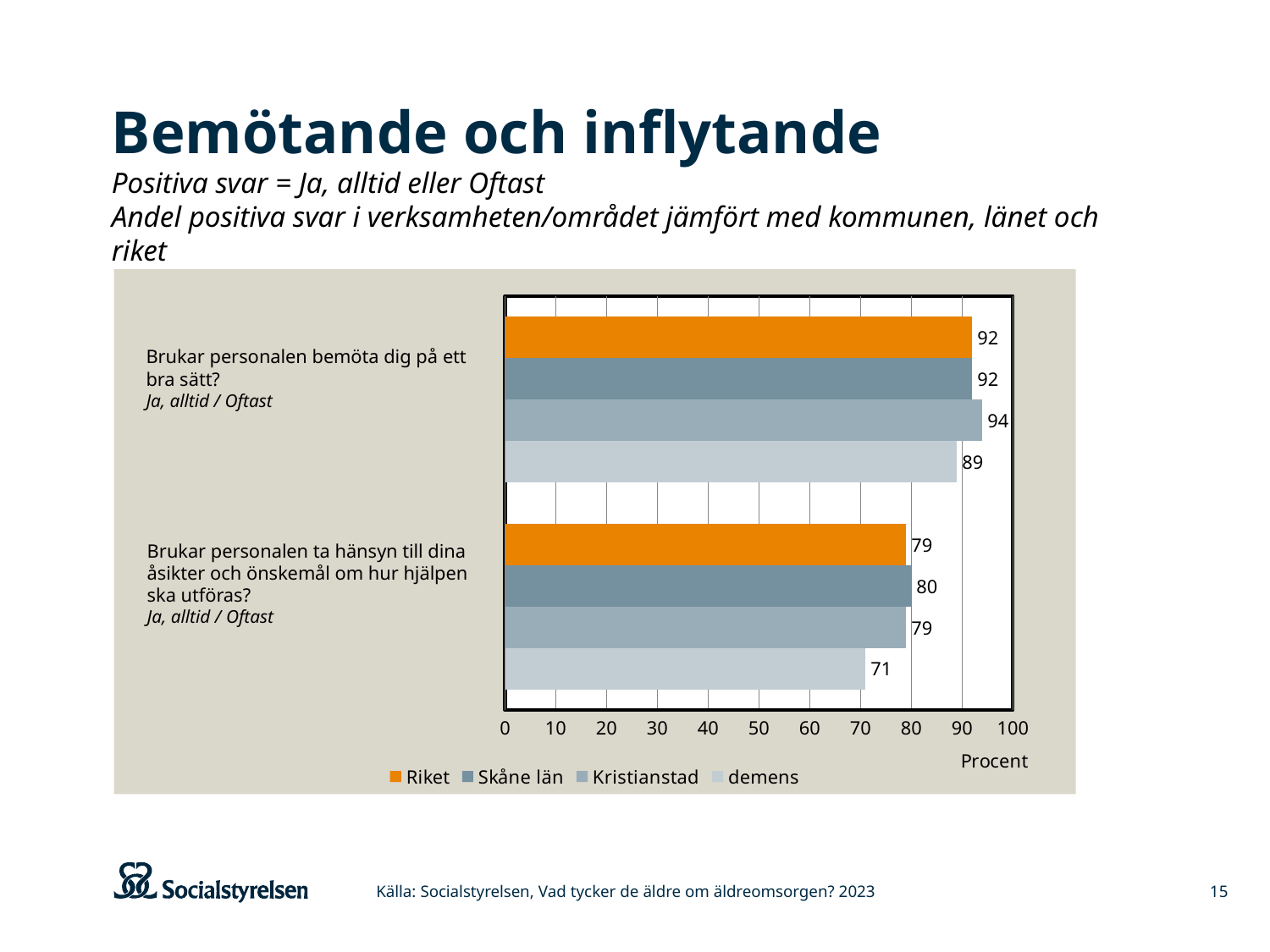
What is the difference between the Kristianstad and demens values for the question "Brukar personalen bemöta dig på ett bra sätt?" 5 What is the value for demens for the question "Brukar personalen ta hänsyn till dina åsikter och önskemål om hur hjälpen ska utföras?" 71 Which series has the lowest value for the question "Brukar personalen ta hänsyn till dina åsikter och önskemål om hur hjälpen ska utföras?" demens What is the value for Skåne län for the question "Brukar personalen bemöta dig på ett bra sätt?" 92 What is the difference between the Skåne län and demens values for the question "Brukar personalen ta hänsyn till dina åsikter och önskemål om hur hjälpen ska utföras?" 9 What is the value for Riket for the question "Brukar personalen ta hänsyn till dina åsikter och önskemål om hur hjälpen ska utföras?" 79 Which series has the highest value for the question "Brukar personalen bemöta dig på ett bra sätt?" Kristianstad What label is shown on the horizontal axis of the chart? Procent What is the value for Kristianstad for the question "Brukar personalen bemöta dig på ett bra sätt?" 94 How many series does the legend list? 4 What kind of chart is shown on the slide? bar chart Which is larger: the Riket value for "Brukar personalen bemöta dig på ett bra sätt?" or the Riket value for "Brukar personalen ta hänsyn till dina åsikter och önskemål om hur hjälpen ska utföras?" Brukar personalen bemöta dig på ett bra sätt?